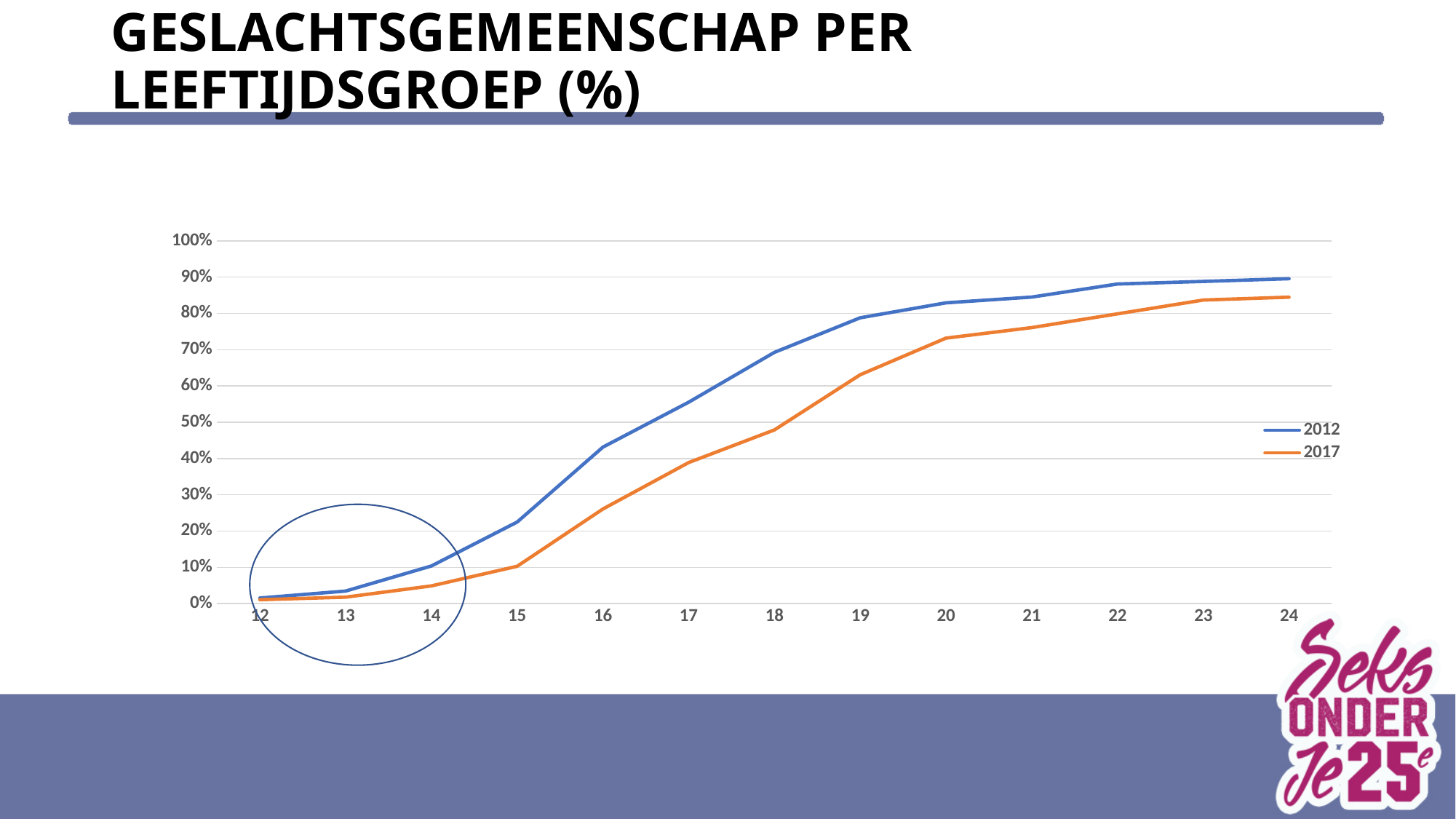
Is the value for 2017 at age 16 greater or less than 30%? less At which age is the 2012 series at its lowest value? 12 At age 17, which series has the higher value, 2012 or 2017? 2012 Which series are listed in the legend? 2012 and 2017 What kind of chart is shown on the slide? line chart Do the values for the 2012 series rise or fall as age increases from 12 to 24? rise Is the value for 2012 at age 22 greater or less than 80%? greater At which age does the 2017 series reach its highest value? 24 Is the value for 2012 at age 16 greater or less than 40%? greater How many age categories are shown on the x axis? 13 How many series does the legend list? 2